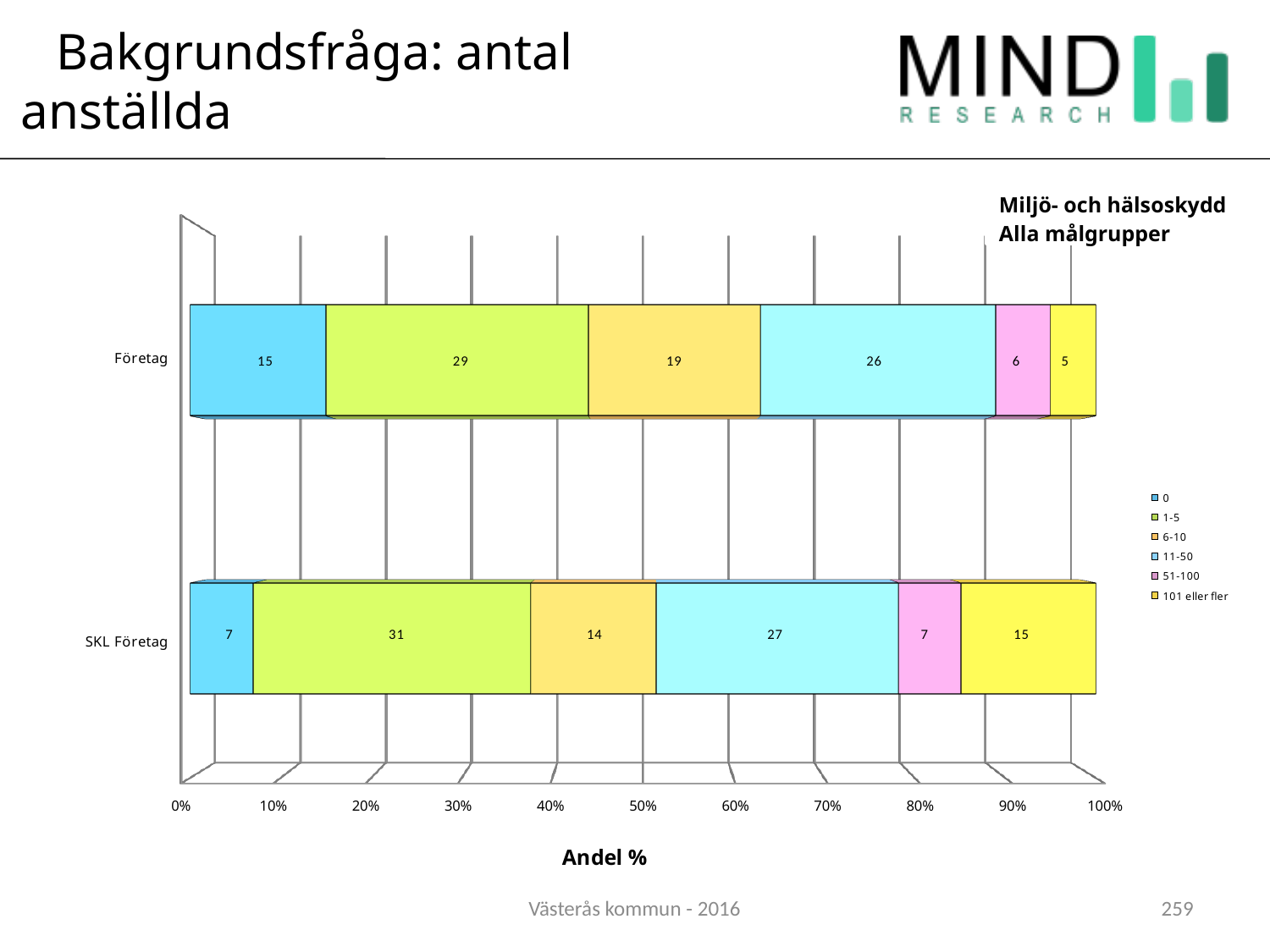
What kind of chart is shown on the slide? Stacked bar chart What is the value of the "0" segment for Företag? 15 How many categories are shown on the vertical axis? 2 What is the difference between the "6-10" values for Företag and SKL Företag? 5 Which segment is the largest in the SKL Företag bar? 1-5 Which has a larger "0" segment, Företag or SKL Företag? Företag Which segment is the smallest in the Företag bar? 101 eller fler What is the label of the horizontal axis? Andel % What is the value of the "101 eller fler" segment for SKL Företag? 15 How many series does the legend list? 6 What is the value of the "1-5" segment for Företag? 29 What is the value of the "11-50" segment for SKL Företag? 27